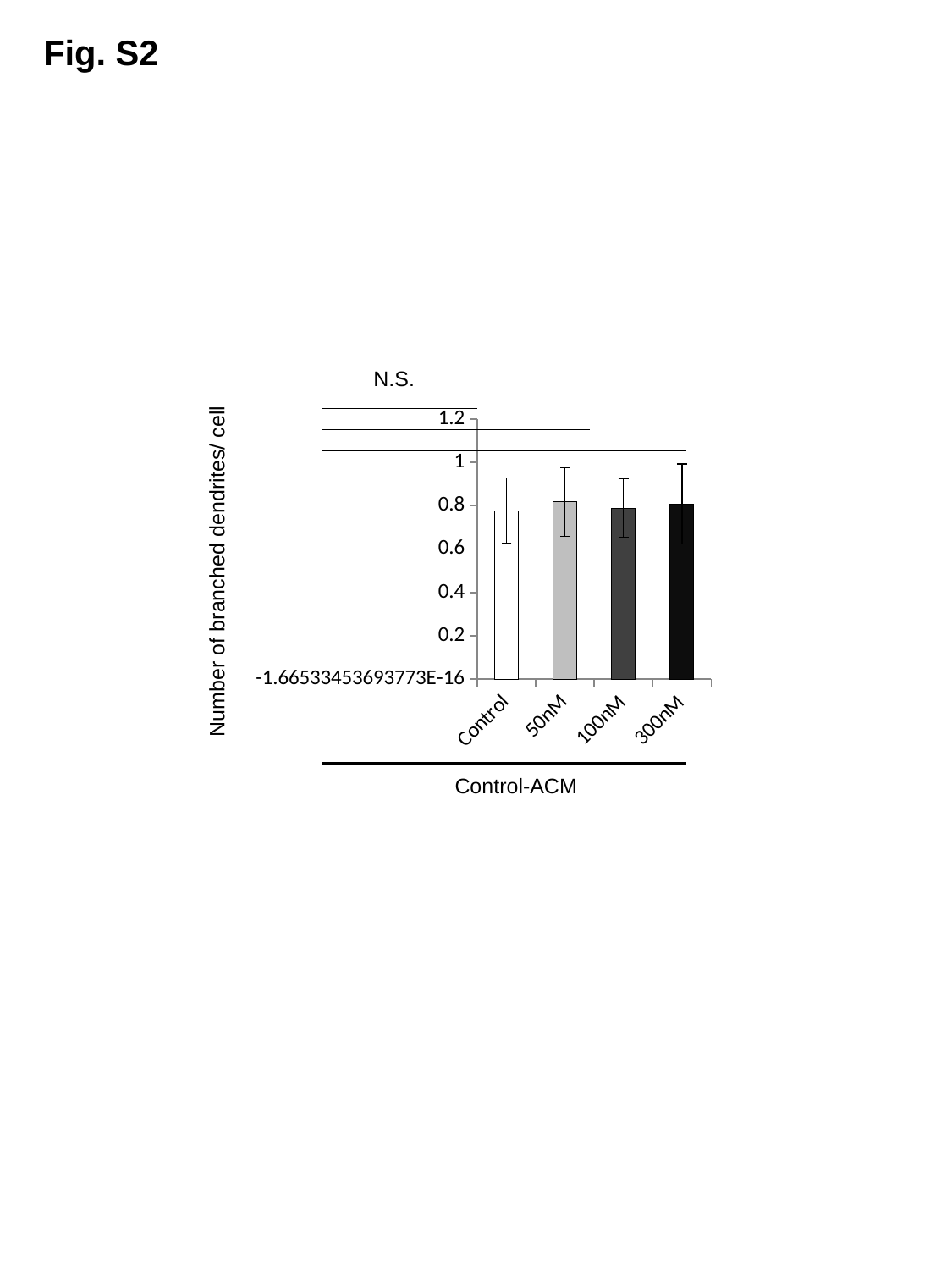
Is the value for 300nM greater or less than 1? less What label appears beneath the x-axis categories, under the thick horizontal line? Control-ACM What is the label of the y axis? Number of branched dendrites/ cell How many categories (bars) are plotted on the chart? 4 Is the value for 300nM greater or less than 0.4? greater Is the value for Control greater or less than 1.2? less What kind of chart is shown on the slide? bar chart